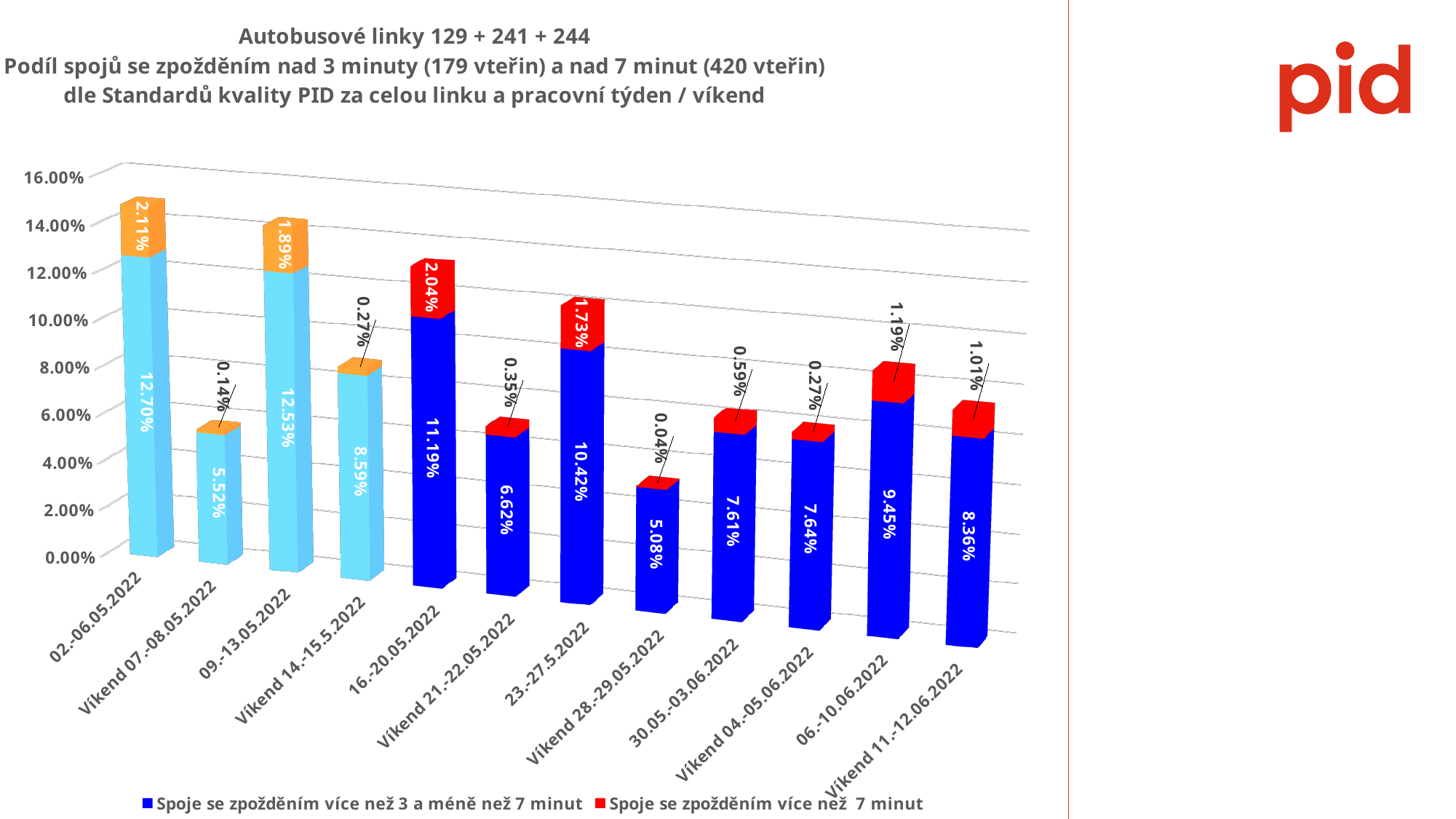
What is the value of 'Spoje se zpožděním více než 3 a méně než 7 minut' for 02.-06.05.2022? 12.70% How many categories (periods) are shown on the x axis? 12 What is the value of 'Spoje se zpožděním více než 7 minut' for 16.-20.05.2022? 2.04% What is the total of the stacked bar for Víkend 28.-29.05.2022? 5.12% Which period has the highest value for 'Spoje se zpožděním více než 3 a méně než 7 minut'? 02.-06.05.2022 What is the total of the stacked bar for 02.-06.05.2022? 14.81% How many series does the legend list? 2 What is the value of 'Spoje se zpožděním více než 3 a méně než 7 minut' for Víkend 11.-12.06.2022? 8.36% Which period has the lowest value for 'Spoje se zpožděním více než 7 minut'? Víkend 28.-29.05.2022 What is the difference between the 'Spoje se zpožděním více než 3 a méně než 7 minut' values for 02.-06.05.2022 and 09.-13.05.2022? 0.17% What type of chart is shown on the slide? Stacked bar chart Which is larger: the 'Spoje se zpožděním více než 3 a méně než 7 minut' value for 06.-10.06.2022 or for Víkend 11.-12.06.2022? 06.-10.06.2022